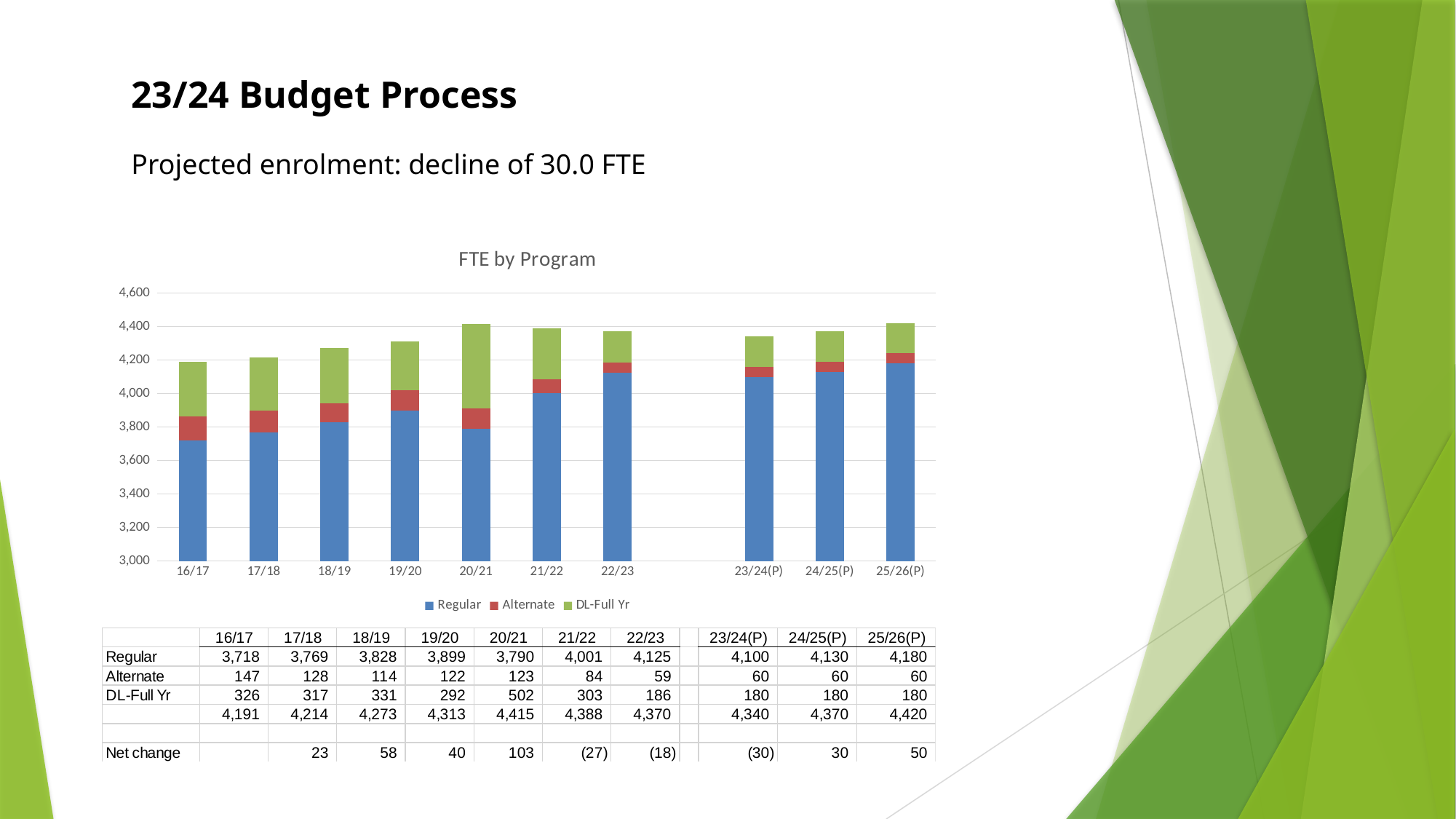
What is the Regular FTE value for 22/23 in the FTE by Program chart? 4,125 Is the total FTE for 20/21 greater or less than 4,400? greater How many series does the legend of the FTE by Program chart list? 3 What kind of chart is FTE by Program? Stacked bar chart What is the difference between the Regular value for 22/23 and the Regular value for 16/17? 407 Which year has the highest DL-Full Yr value? 20/21 Which year has the lowest total FTE? 16/17 What is the total FTE for 23/24(P)? 4,340 What is the DL-Full Yr value for 20/21? 502 What is the Alternate value for 21/22? 84 Which is larger, the Alternate value for 16/17 or the Alternate value for 22/23? 16/17 How many years are shown on the x axis of the FTE by Program chart? 10